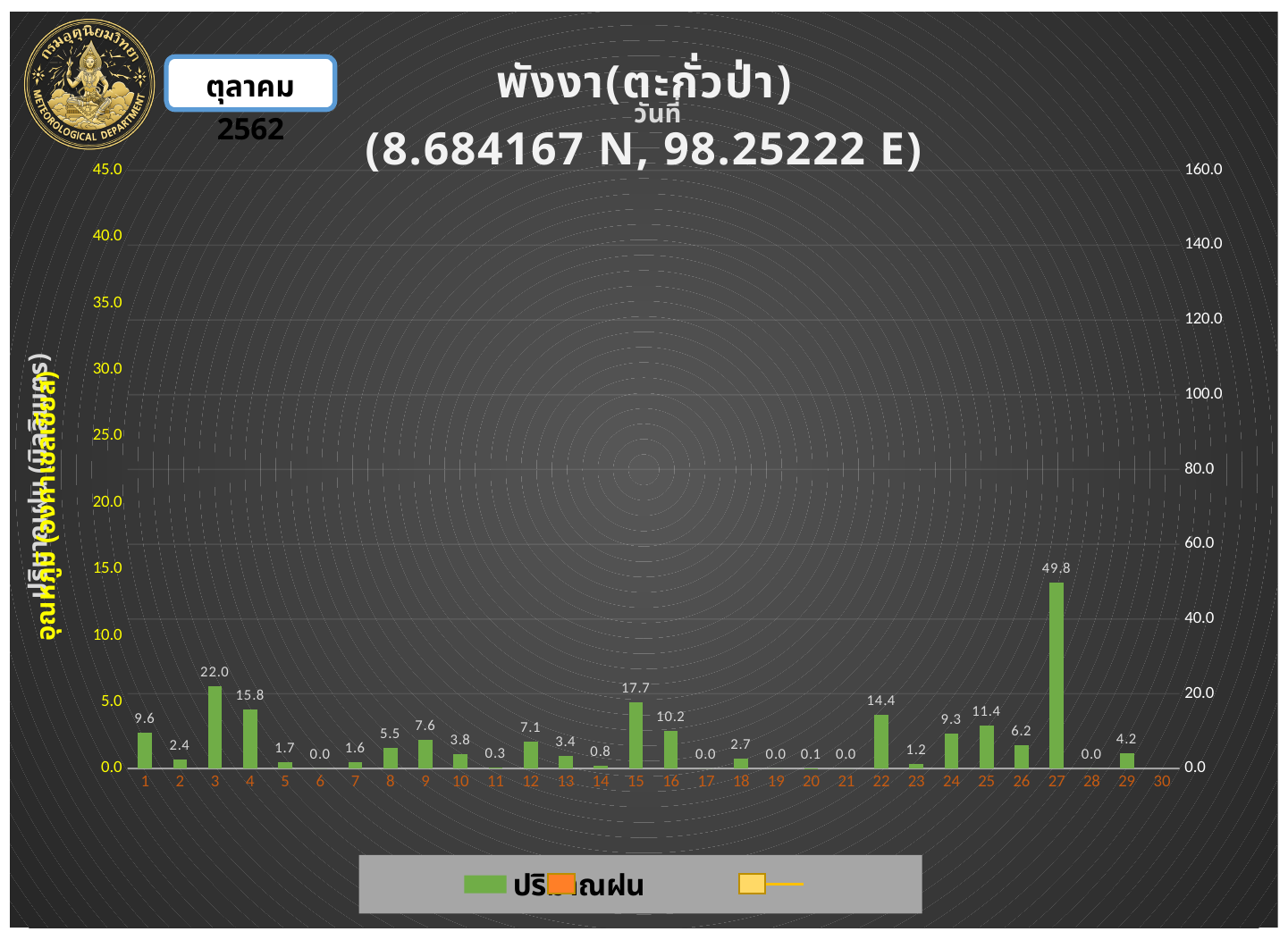
What kind of chart is shown on the slide? bar chart What colour are the bars in the chart? green What is the difference between the values for day 27 and day 3? 27.8 Which day has the highest value? 27 Which is larger, the value for day 15 or the value for day 16? day 15 What is the difference between the values for day 3 and day 4? 6.2 What is the value shown for day 15? 17.7 How many days are labelled along the x axis? 30 What is the value shown for day 3? 22.0 What is the value shown for day 22? 14.4 Which is larger, the value for day 24 or the value for day 25? day 25 What is the rainfall value shown for day 27? 49.8